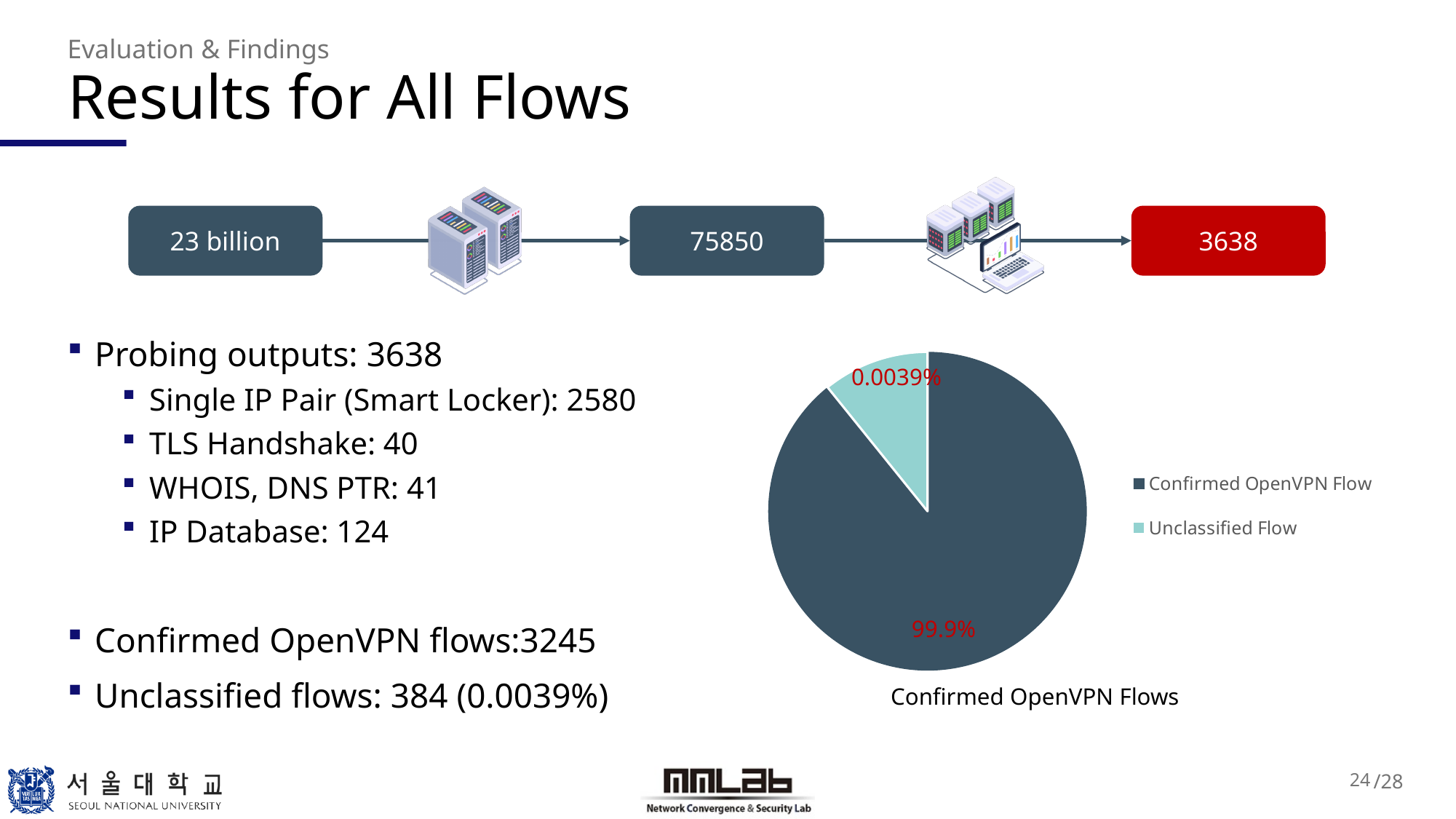
Which slice of the pie chart is the smallest? Unclassified Flow What share of the pie is labelled for Unclassified Flow? 0.0039% What value is printed on the Unclassified Flow slice? 0.0039% What share of the pie is labelled for Confirmed OpenVPN Flow? 99.9% How many slices does the pie chart have? 2 Which is larger in the pie chart, Confirmed OpenVPN Flow or Unclassified Flow? Confirmed OpenVPN Flow What kind of chart is shown on the slide? pie chart How many entries does the pie chart's legend list? 2 What value is printed on the Confirmed OpenVPN Flow slice? 99.9% Which slice of the pie chart is the largest? Confirmed OpenVPN Flow Which legend entry is shown in the light teal colour? Unclassified Flow What is the title of the pie chart? Confirmed OpenVPN Flows